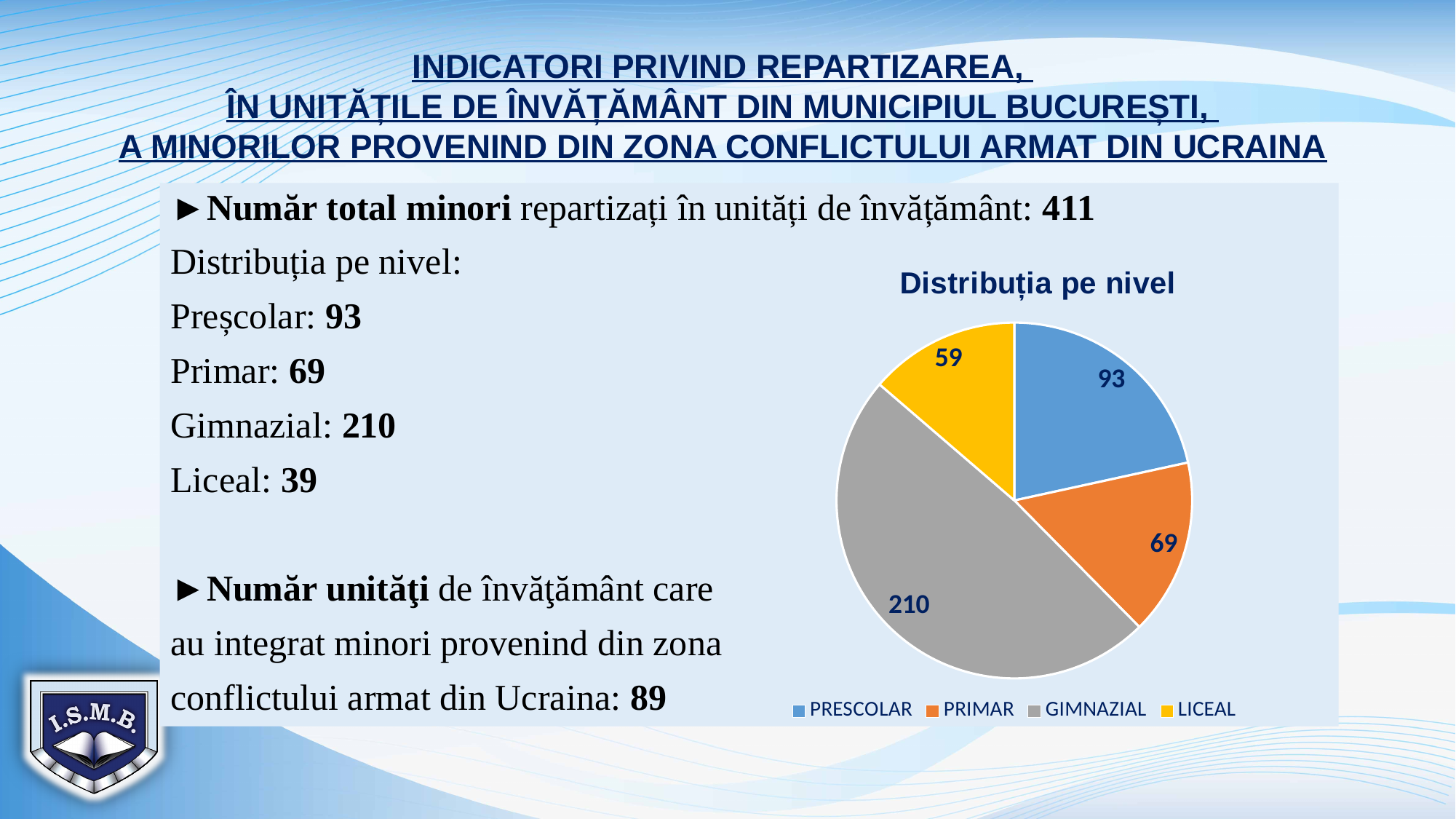
Which category has the smallest slice in the pie chart? LICEAL What is the title of the chart? Distribuția pe nivel What is the value for GIMNAZIAL in the pie chart? 210 What is the difference between the GIMNAZIAL and PRESCOLAR values in the pie chart? 117 How many categories does the pie chart show? 4 What is the difference between the PRESCOLAR and PRIMAR values in the pie chart? 24 Which is larger in the pie chart, PRIMAR or LICEAL? PRIMAR What is the value for PRESCOLAR in the pie chart? 93 What is the value shown for LICEAL in the pie chart? 59 What type of chart is shown on the slide? Pie chart What is the value for PRIMAR in the pie chart? 69 Which category has the largest slice in the pie chart? GIMNAZIAL